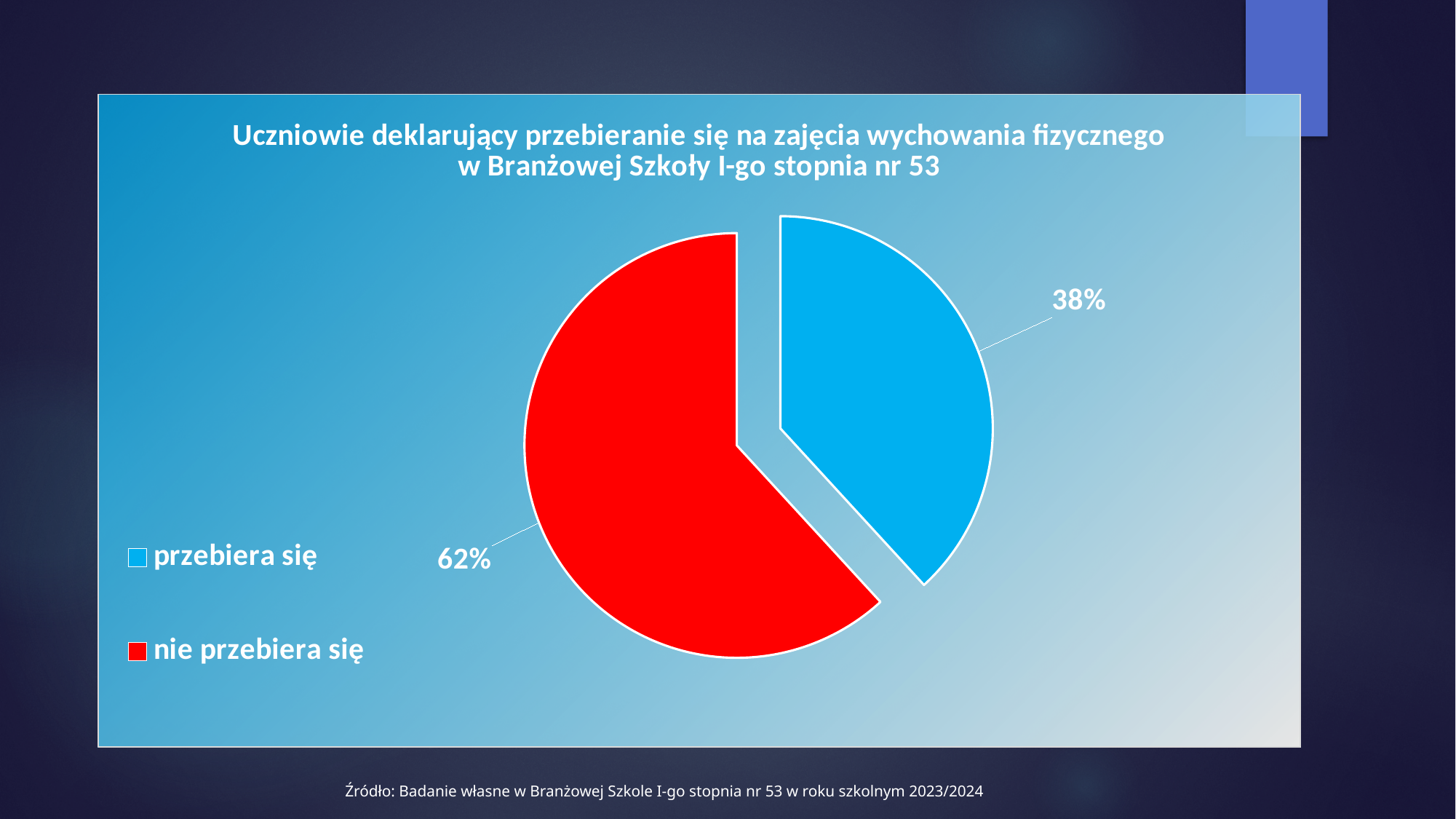
What colour is the slice for "nie przebiera się"? red Is the share for "przebiera się" greater or less than 50%? less What kind of chart is shown on the slide? pie chart What is the difference in percentage points between "nie przebiera się" and "przebiera się"? 24 What share of students is labelled "przebiera się"? 38% Which category has the largest slice of the pie? nie przebiera się Which category has the smallest slice of the pie? przebiera się How many slices does the pie chart have? 2 How many entries does the legend list? 2 What share of students is labelled "nie przebiera się"? 62% Which is larger: the share for "przebiera się" or for "nie przebiera się"? nie przebiera się What colour is the slice for "przebiera się"? blue